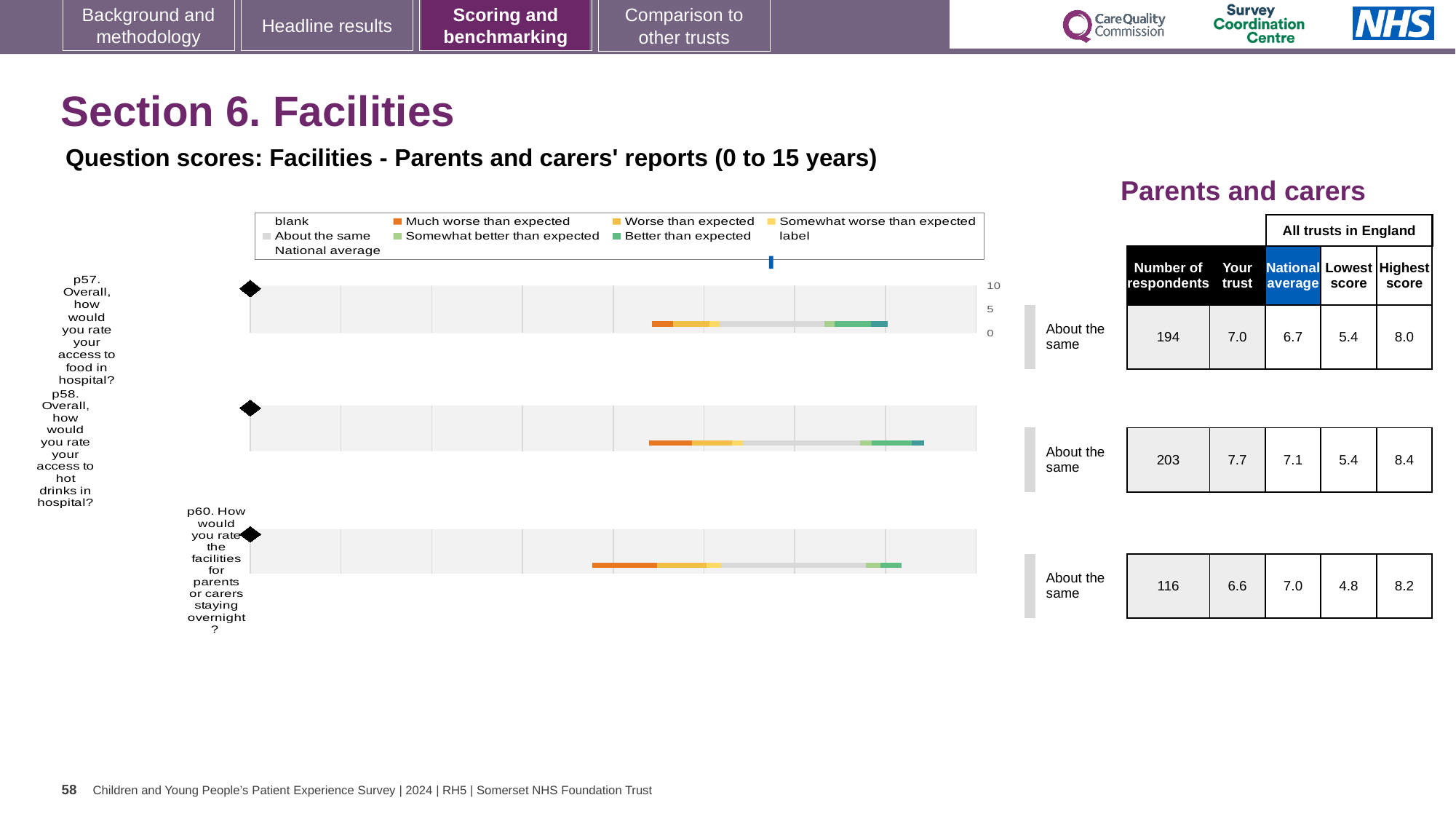
What benchmark category is shown for p57 (access to food in hospital)? About the same What kind of chart is used to show the question scores? Bar chart Which question has the lowest 'Your trust' score? p60 (facilities for parents or carers staying overnight) For p60 (facilities for parents or carers staying overnight), which is higher: the 'Your trust' score or the national average? National average What is the lowest score among all trusts in England for p60 (facilities for parents or carers staying overnight)? 4.8 How many survey questions are plotted on this slide? 3 What is the highest score among all trusts in England for p58 (access to hot drinks)? 8.4 How many respondents answered p60 (facilities for parents or carers staying overnight)? 116 What is the national average score for p58 (access to hot drinks in hospital)? 7.1 Which question has the largest number of respondents? p58 (access to hot drinks in hospital) For p58 (access to hot drinks), what is the difference between the 'Your trust' score and the national average? 0.6 What is the 'Your trust' score for p57 (access to food in hospital)? 7.0